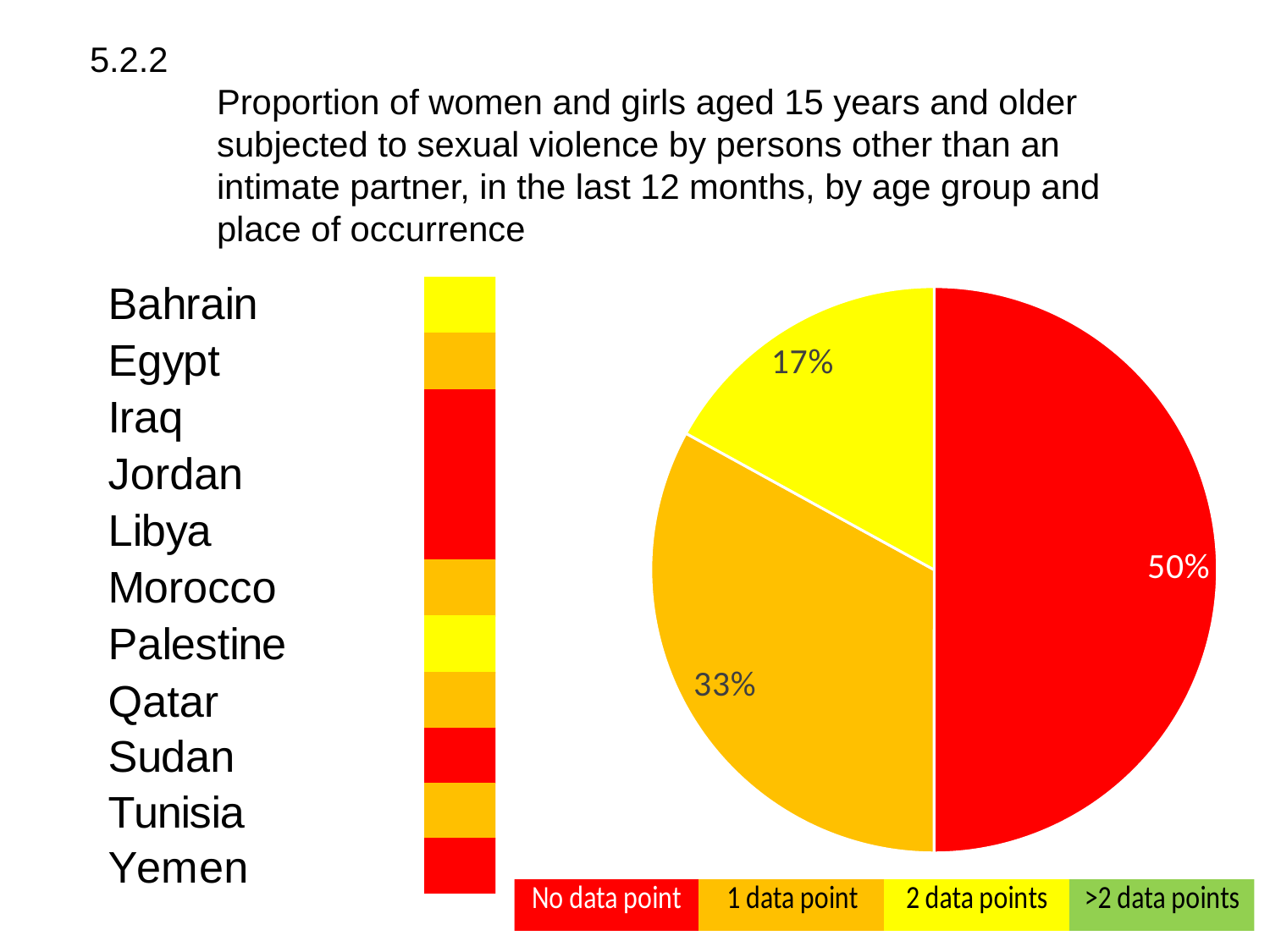
How many entries does the legend below the pie chart list? 4 Which category has the smallest slice in the pie chart? 2 data points What is the difference between the 1 data point share and the 2 data points share in the pie chart? 16% Which is larger in the pie chart, the 1 data point slice or the 2 data points slice? 1 data point What share of the pie chart is the red slice (No data point)? 50% What is the difference between the No data point share and the 1 data point share in the pie chart? 17% What share of the pie chart is the orange slice (1 data point)? 33% What kind of chart is shown on the right of the slide? pie chart How many slices does the pie chart have? 3 What share of the pie chart is the yellow slice (2 data points)? 17% Which category has the largest slice in the pie chart? No data point Which colour represents '>2 data points' in the legend? green